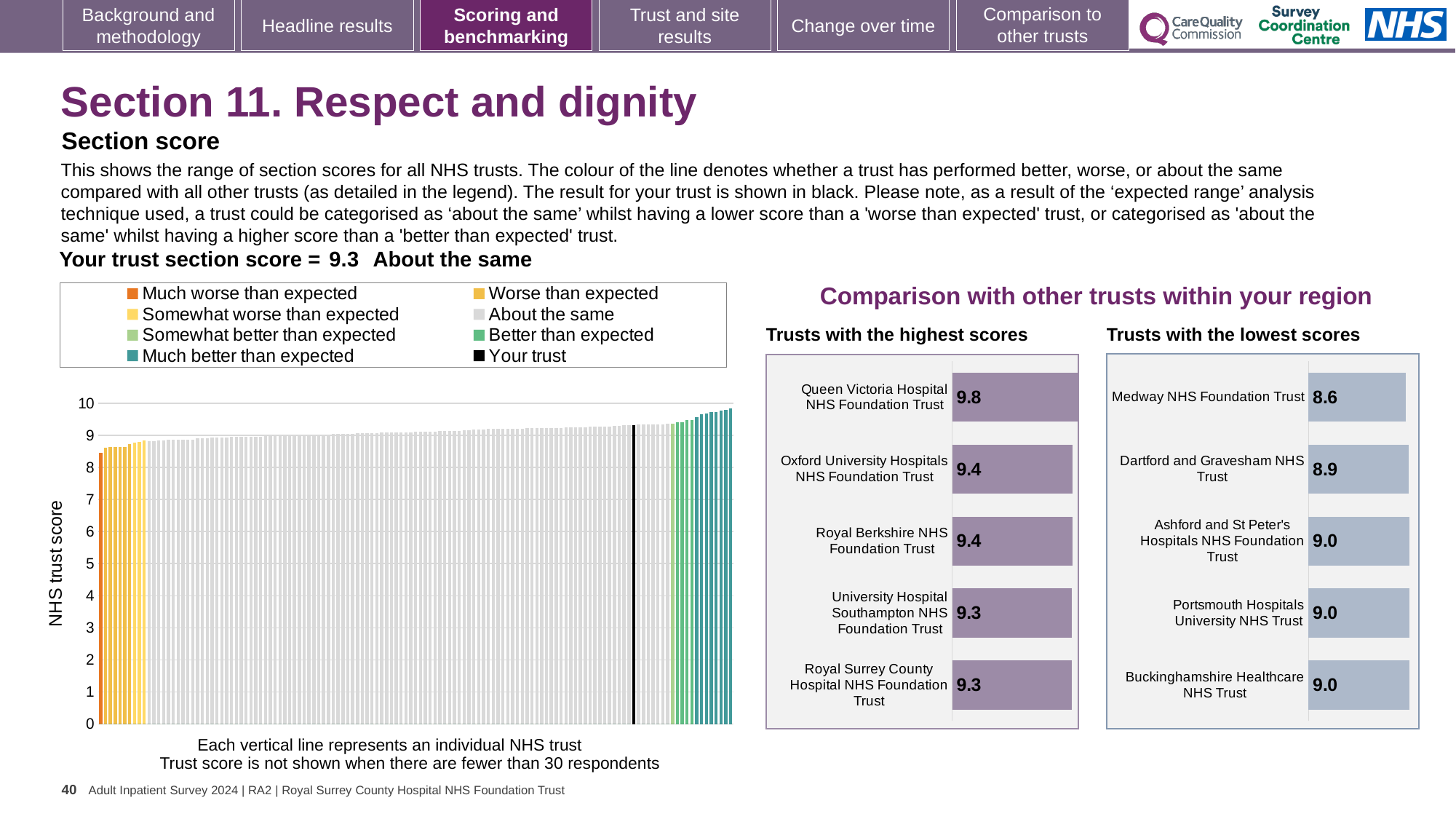
How many trusts are shown in the 'Trusts with the highest scores' chart? 5 In the 'Trusts with the highest scores' chart, which trust has the highest score? Queen Victoria Hospital NHS Foundation Trust In the large chart on the left, do the NHS trust scores rise or fall from left to right? Rise How many entries does the legend above the large chart on the left list? 8 What is the section score for your trust shown on the slide? 9.3 In the 'Trusts with the lowest scores' chart, which trust has the lowest score? Medway NHS Foundation Trust In the 'Trusts with the lowest scores' chart, how much higher is Dartford and Gravesham NHS Trust's score than Medway NHS Foundation Trust's? 0.3 What kind of chart is the large chart on the left showing NHS trust scores? Bar chart In the 'Trusts with the lowest scores' chart, what is the score for Medway NHS Foundation Trust? 8.6 In the 'Trusts with the highest scores' chart, what is the difference between the scores of Queen Victoria Hospital NHS Foundation Trust and Royal Surrey County Hospital NHS Foundation Trust? 0.5 In the 'Trusts with the highest scores' chart, which has the higher score: Oxford University Hospitals NHS Foundation Trust or University Hospital Southampton NHS Foundation Trust? Oxford University Hospitals NHS Foundation Trust In the 'Trusts with the highest scores' chart, what is the score for Queen Victoria Hospital NHS Foundation Trust? 9.8